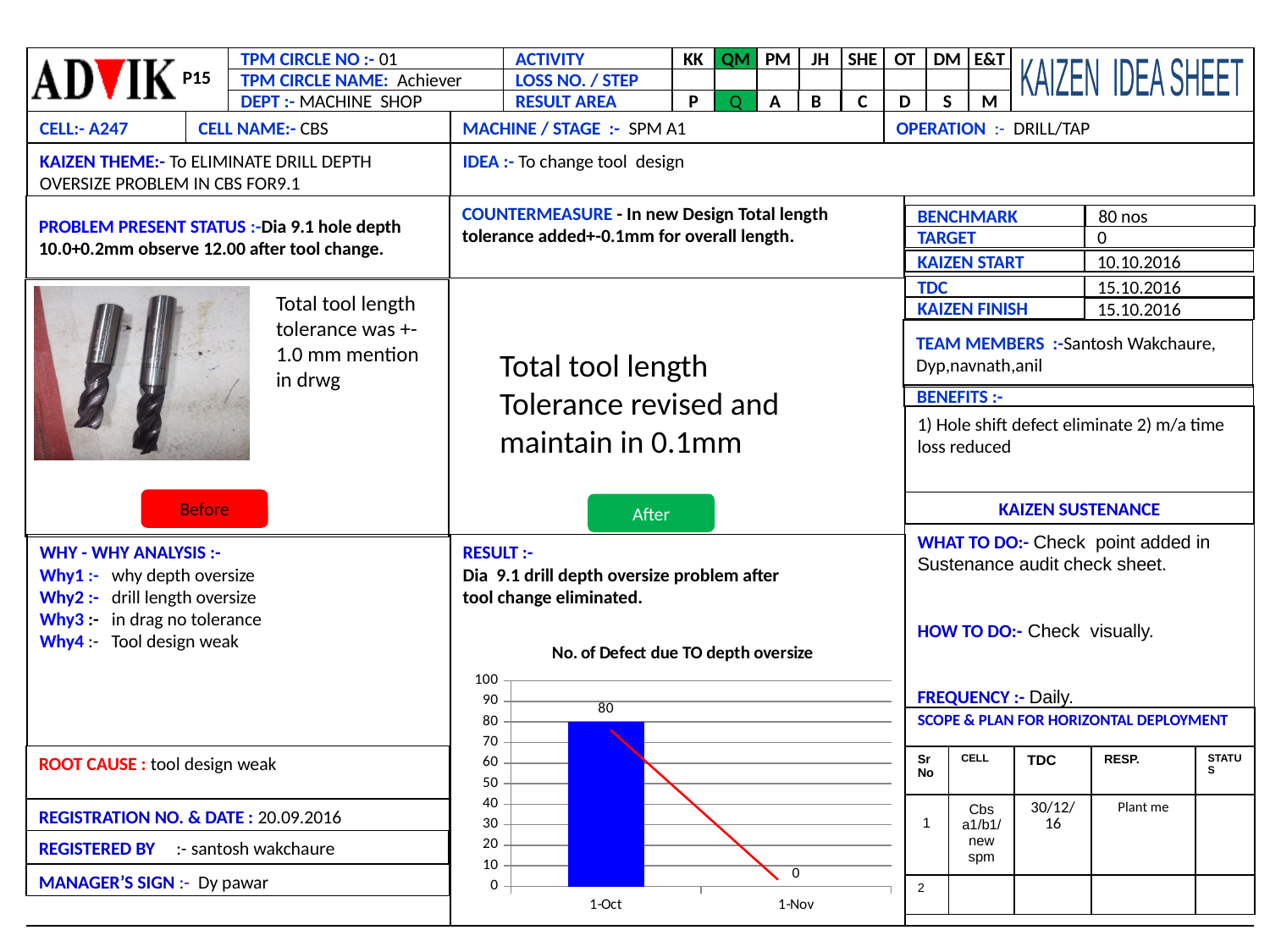
Which category has the highest value in the chart? 1-Oct What is the maximum value shown on the y axis of the chart? 100 Is the value for 1-Oct greater or less than 50? greater How many categories are shown on the x axis of the chart? 2 What is the title of the chart on the slide? No. of Defect due TO depth oversize What is the difference between the values for 1-Oct and 1-Nov? 80 What is the value for 1-Nov in the chart? 0 Do the values rise or fall from 1-Oct to 1-Nov? fall What is the value for 1-Oct in the chart? 80 What type of chart is shown on the slide? bar chart Which is larger, the value for 1-Oct or the value for 1-Nov? 1-Oct Which category has the lowest value in the chart? 1-Nov